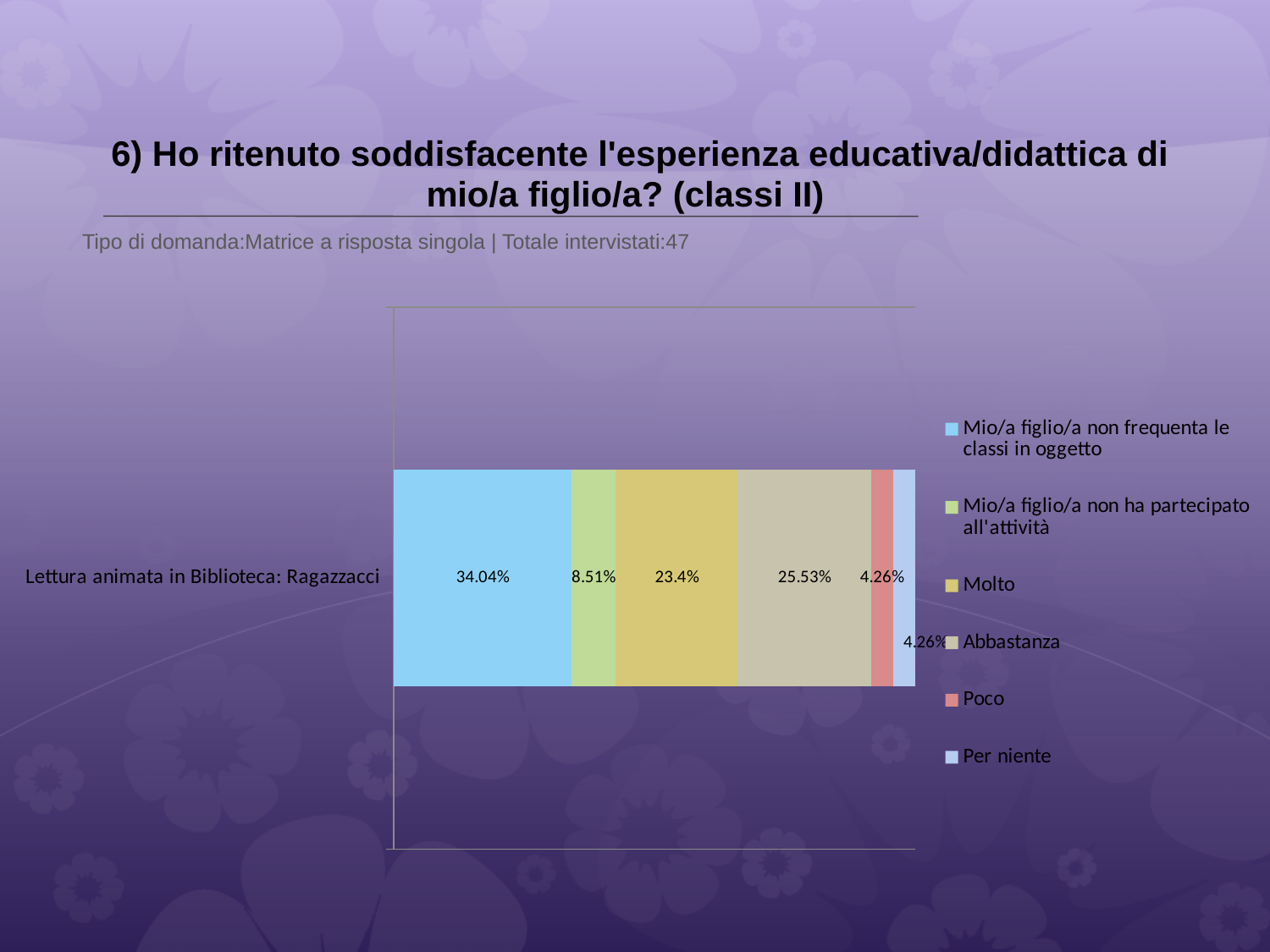
What is the value for 'Molto' for Lettura animata in Biblioteca: Ragazzacci? 23.4% How many series does the legend list? 6 What kind of chart is shown on the slide? stacked bar chart How many categories are plotted on the chart? 1 Which is larger for Lettura animata in Biblioteca: Ragazzacci, 'Molto' or 'Abbastanza'? Abbastanza What is the value for 'Poco' for Lettura animata in Biblioteca: Ragazzacci? 4.26% What is the name of the single category plotted on the chart? Lettura animata in Biblioteca: Ragazzacci What is the value for 'Abbastanza' for Lettura animata in Biblioteca: Ragazzacci? 25.53% What is the value for 'Mio/a figlio/a non frequenta le classi in oggetto' for Lettura animata in Biblioteca: Ragazzacci? 34.04% Which series has the highest value for Lettura animata in Biblioteca: Ragazzacci? Mio/a figlio/a non frequenta le classi in oggetto What is the value for 'Mio/a figlio/a non ha partecipato all'attività' for Lettura animata in Biblioteca: Ragazzacci? 8.51% What is the difference between the 'Abbastanza' and 'Molto' values for Lettura animata in Biblioteca: Ragazzacci? 2.13%